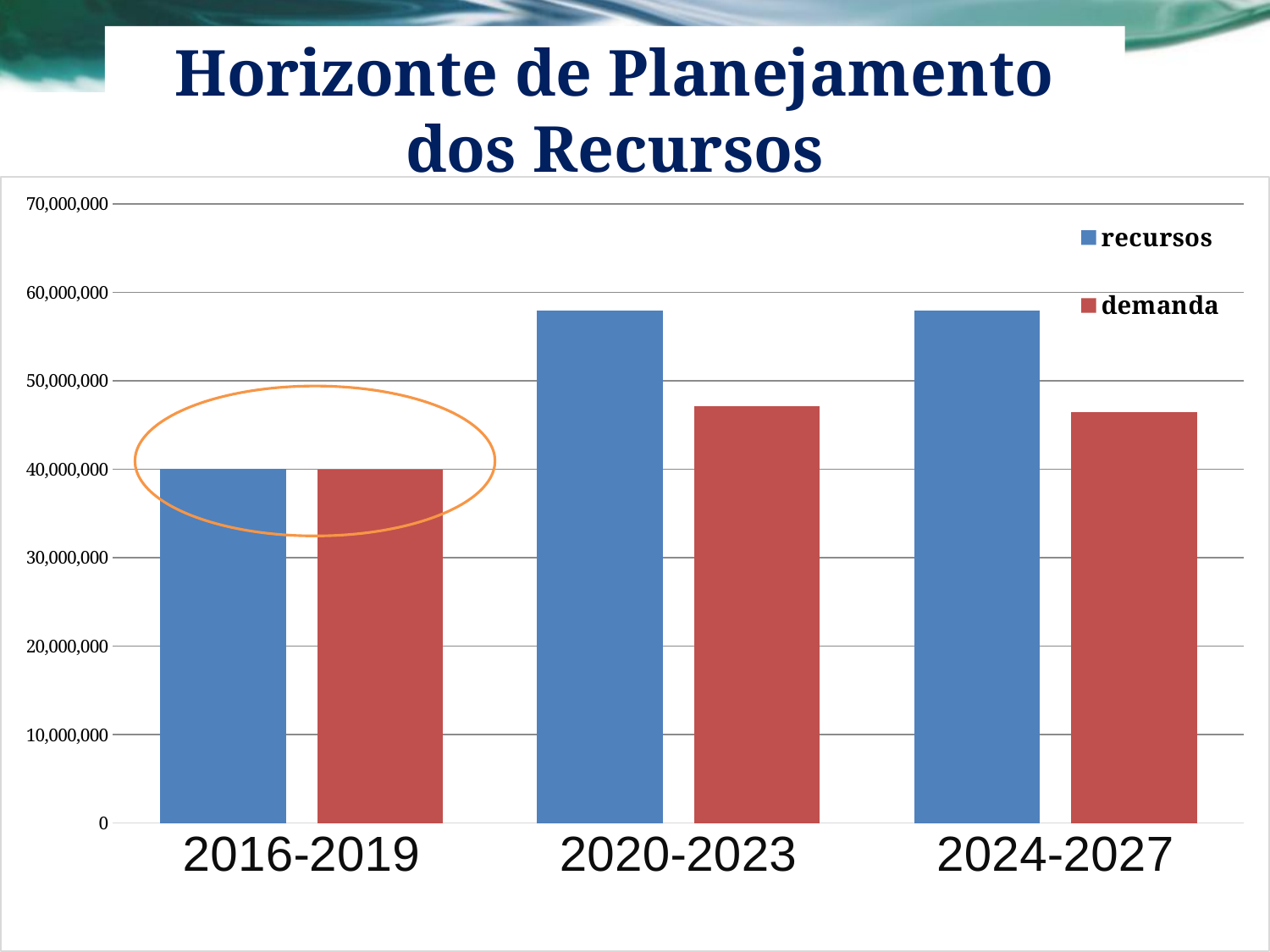
What kind of chart is shown on the slide? bar chart Is the value of demanda for 2024-2027 greater or less than 40,000,000? greater What is the title of the slide containing the chart? Horizonte de Planejamento dos Recursos Does the value of recursos rise or fall from 2016-2019 to 2020-2023? rise How many series does the chart legend list? 2 Which period has the lowest value for demanda? 2016-2019 Is the value of demanda for 2020-2023 greater or less than 50,000,000? less In 2020-2023, which is larger, recursos or demanda? recursos Is the value of recursos for 2024-2027 greater or less than 60,000,000? less How many period categories are shown on the x axis? 3